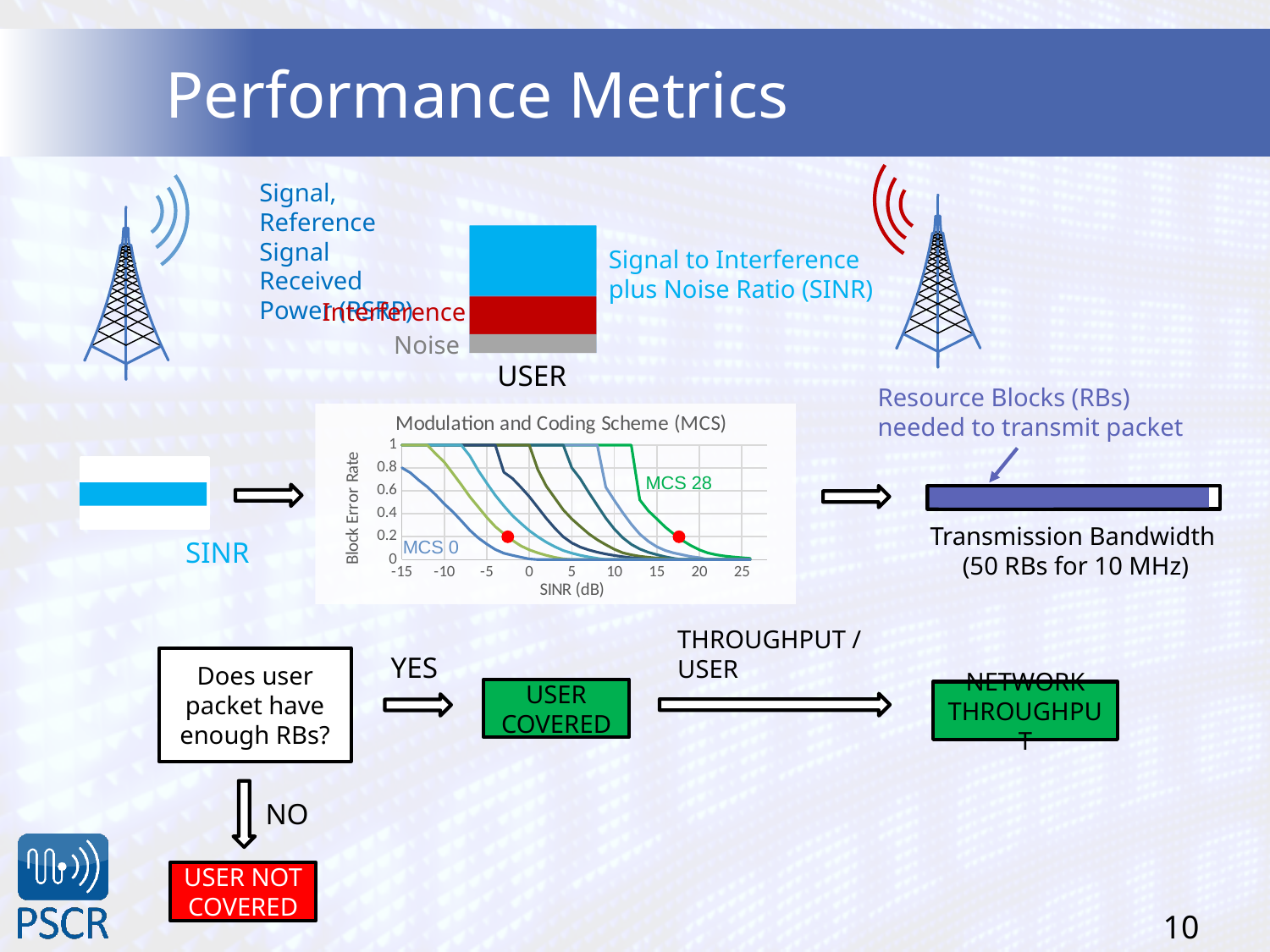
On the Modulation and Coding Scheme (MCS) chart, which labelled curve reaches a Block Error Rate of 0 at a higher SINR, MCS 0 or MCS 28? MCS 28 What is the highest tick value shown on the x axis of the Modulation and Coding Scheme (MCS) chart? 25 How many tick labels are shown on the x axis of the Modulation and Coding Scheme (MCS) chart? 9 What is the title of the chart on the slide? Modulation and Coding Scheme (MCS) How many red dots are marked on the Modulation and Coding Scheme (MCS) chart? 2 What is the lowest tick value shown on the x axis of the Modulation and Coding Scheme (MCS) chart? -15 What kind of chart is the Modulation and Coding Scheme (MCS) chart? line chart What is the label of the x axis on the Modulation and Coding Scheme (MCS) chart? SINR (dB) On the Modulation and Coding Scheme (MCS) chart, does the Block Error Rate rise or fall as SINR increases along each curve? fall What is the highest tick value shown on the y axis of the Modulation and Coding Scheme (MCS) chart? 1 On the Modulation and Coding Scheme (MCS) chart, which labelled curve is furthest to the left, MCS 0 or MCS 28? MCS 0 What is the label of the y axis on the Modulation and Coding Scheme (MCS) chart? Block Error Rate